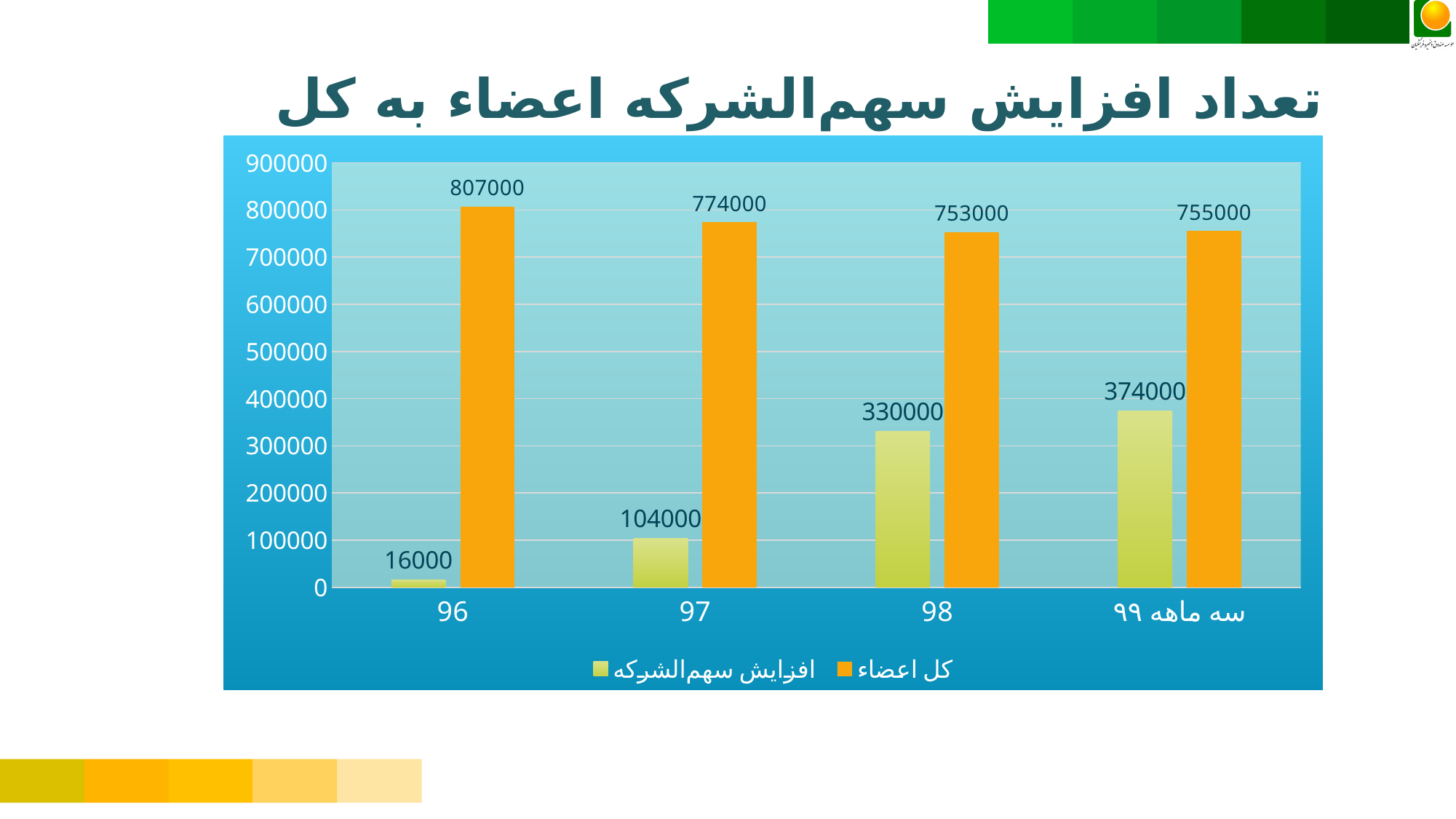
What is the value of افزایش سهم‌الشرکه for سه ماهه ۹۹? 374000 Which category has the lowest value for افزایش سهم‌الشرکه? 96 How many categories are shown on the x axis? 4 Which category has the highest value for کل اعضاء? 96 Which is larger: کل اعضاء for 98 or کل اعضاء for سه ماهه ۹۹? کل اعضاء for سه ماهه ۹۹ How many series does the legend list? 2 Do the values for افزایش سهم‌الشرکه rise or fall from 96 to سه ماهه ۹۹? Rise What kind of chart is shown on the slide? Bar chart What is the value of کل اعضاء for 97? 774000 What is the value of کل اعضاء for 96? 807000 What is the value of افزایش سهم‌الشرکه for 98? 330000 What is the difference between کل اعضاء and افزایش سهم‌الشرکه for 97? 670000